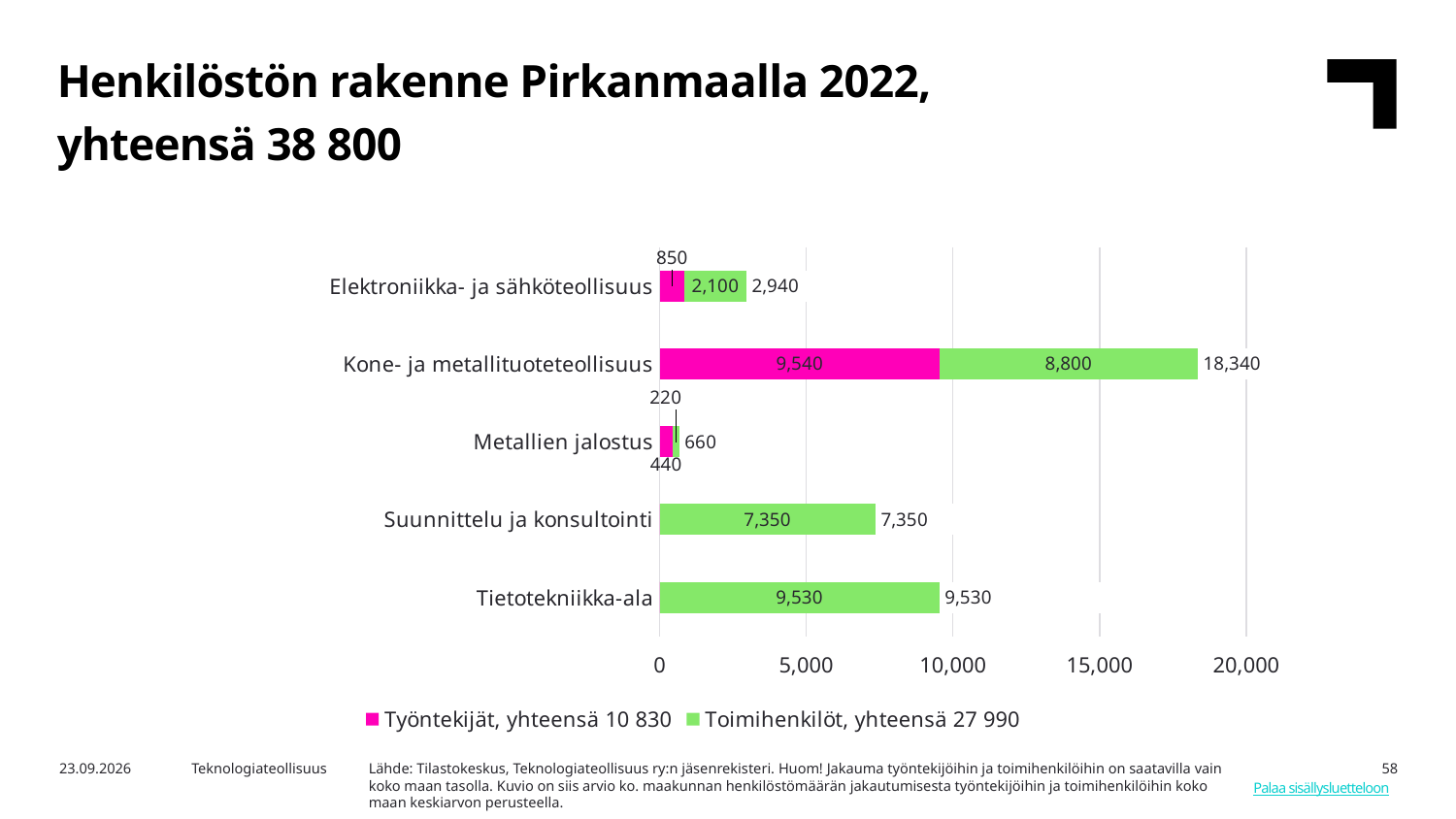
What is the value for Työntekijät in Kone- ja metallituoteteollisuus? 9,540 What is the total of the stacked bar for Kone- ja metallituoteteollisuus? 18,340 What is the total of the stacked bar for Metallien jalostus? 660 How many series does the legend list? 2 What is the value for Toimihenkilöt in Kone- ja metallituoteteollisuus? 8,800 Which category has the lowest total? Metallien jalostus What is the value for Toimihenkilöt in Elektroniikka- ja sähköteollisuus? 2,100 What kind of chart is shown on the slide? Stacked bar chart Which category has the highest total? Kone- ja metallituoteteollisuus Which is larger: the Työntekijät value or the Toimihenkilöt value in Kone- ja metallituoteteollisuus? Työntekijät How many categories are shown on the chart? 5 What is the difference between the Toimihenkilöt values for Tietotekniikka-ala and Suunnittelu ja konsultointi? 2,180